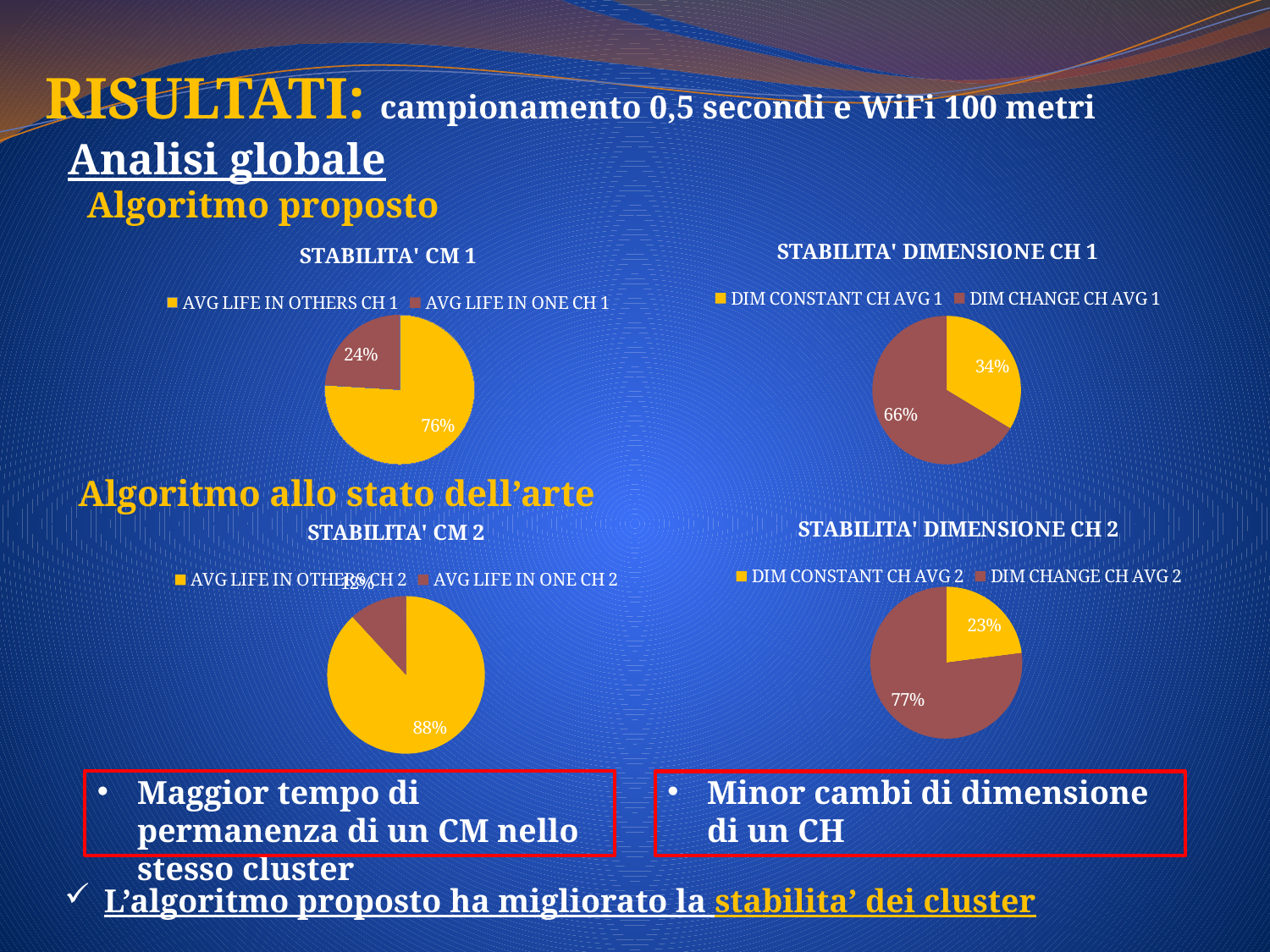
In the STABILITA' DIMENSIONE CH 2 chart, which slice is the largest? DIM CHANGE CH AVG 2 In the STABILITA' CM 1 chart, what is the value for AVG LIFE IN ONE CH 1? 24% How many series does the legend of the STABILITA' DIMENSIONE CH 1 chart list? 2 What kind of chart is STABILITA' CM 2? Pie chart In the STABILITA' CM 2 chart, what is the value for AVG LIFE IN OTHERS CH 2? 88% In the STABILITA' DIMENSIONE CH 1 chart, which slice is the smallest? DIM CONSTANT CH AVG 1 In the STABILITA' CM 1 chart, what share does AVG LIFE IN OTHERS CH 1 have? 76% In the STABILITA' DIMENSIONE CH 1 chart, what is the value for DIM CHANGE CH AVG 1? 66% In the STABILITA' CM 1 chart, what is the difference between AVG LIFE IN OTHERS CH 1 and AVG LIFE IN ONE CH 1? 52% In the STABILITA' DIMENSIONE CH 2 chart, what is the value for DIM CHANGE CH AVG 2? 77% In the STABILITA' DIMENSIONE CH 1 chart, what share does DIM CONSTANT CH AVG 1 have? 34% In the STABILITA' DIMENSIONE CH 2 chart, what is the value for DIM CONSTANT CH AVG 2? 23%